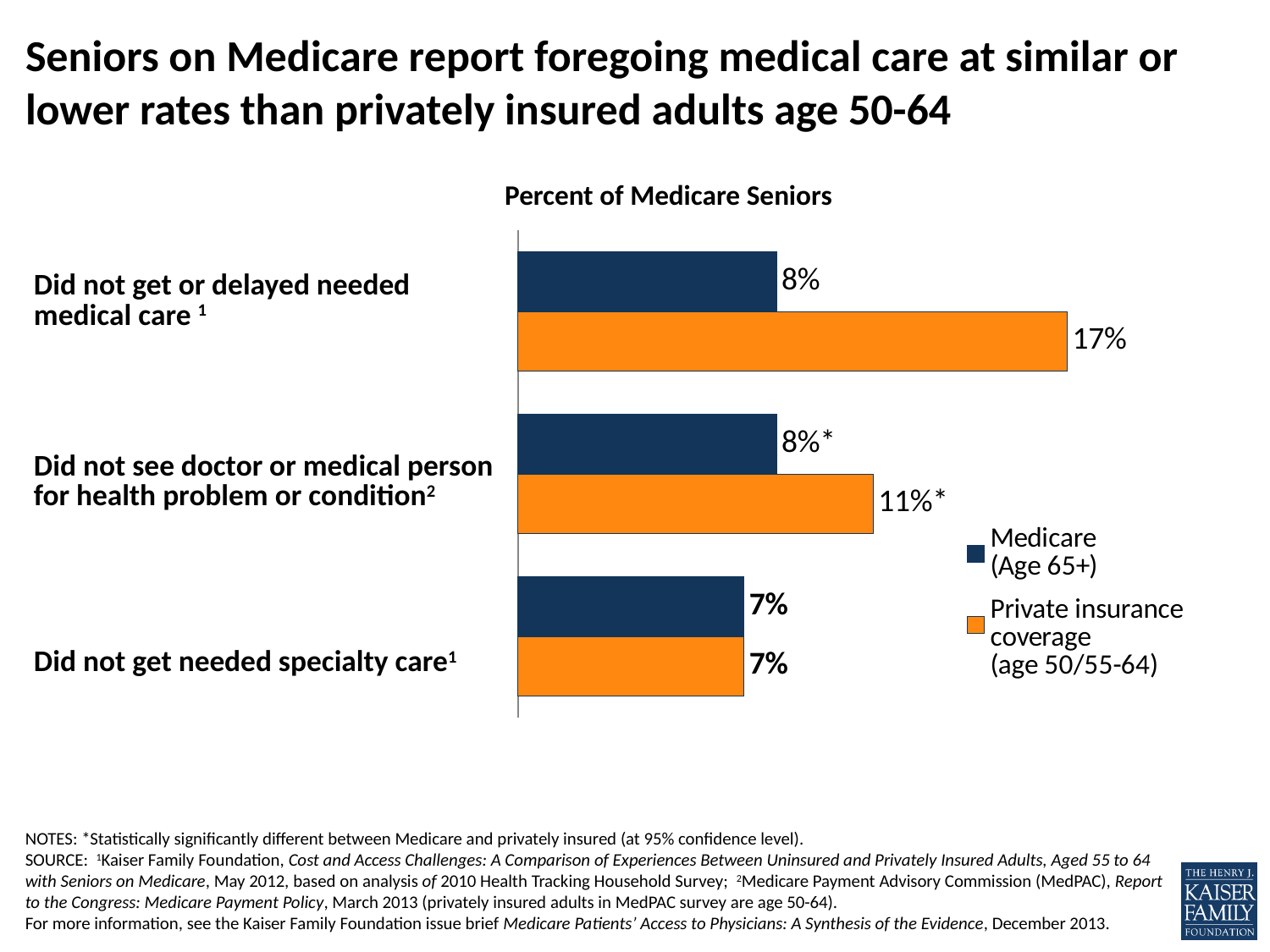
What is the value for private insurance coverage for 'Did not see doctor or medical person for health problem or condition'? 11%* What percent of Medicare seniors (Age 65+) did not get or delayed needed medical care? 8% What is the title of the chart? Percent of Medicare Seniors What is the value for Medicare (Age 65+) for 'Did not get needed specialty care'? 7% For 'Did not see doctor or medical person for health problem or condition', which group has the larger value, Medicare or private insurance coverage? Private insurance coverage How many categories are shown on the chart? 3 What is the difference between the private insurance and Medicare values for 'Did not get or delayed needed medical care'? 9 percentage points Which colour represents Medicare (Age 65+) in the chart? Dark blue What kind of chart is shown on the slide? Bar chart What percent of adults with private insurance coverage (age 50/55-64) did not get or delayed needed medical care? 17% How many series does the legend list? 2 Which category has the highest value for private insurance coverage? Did not get or delayed needed medical care